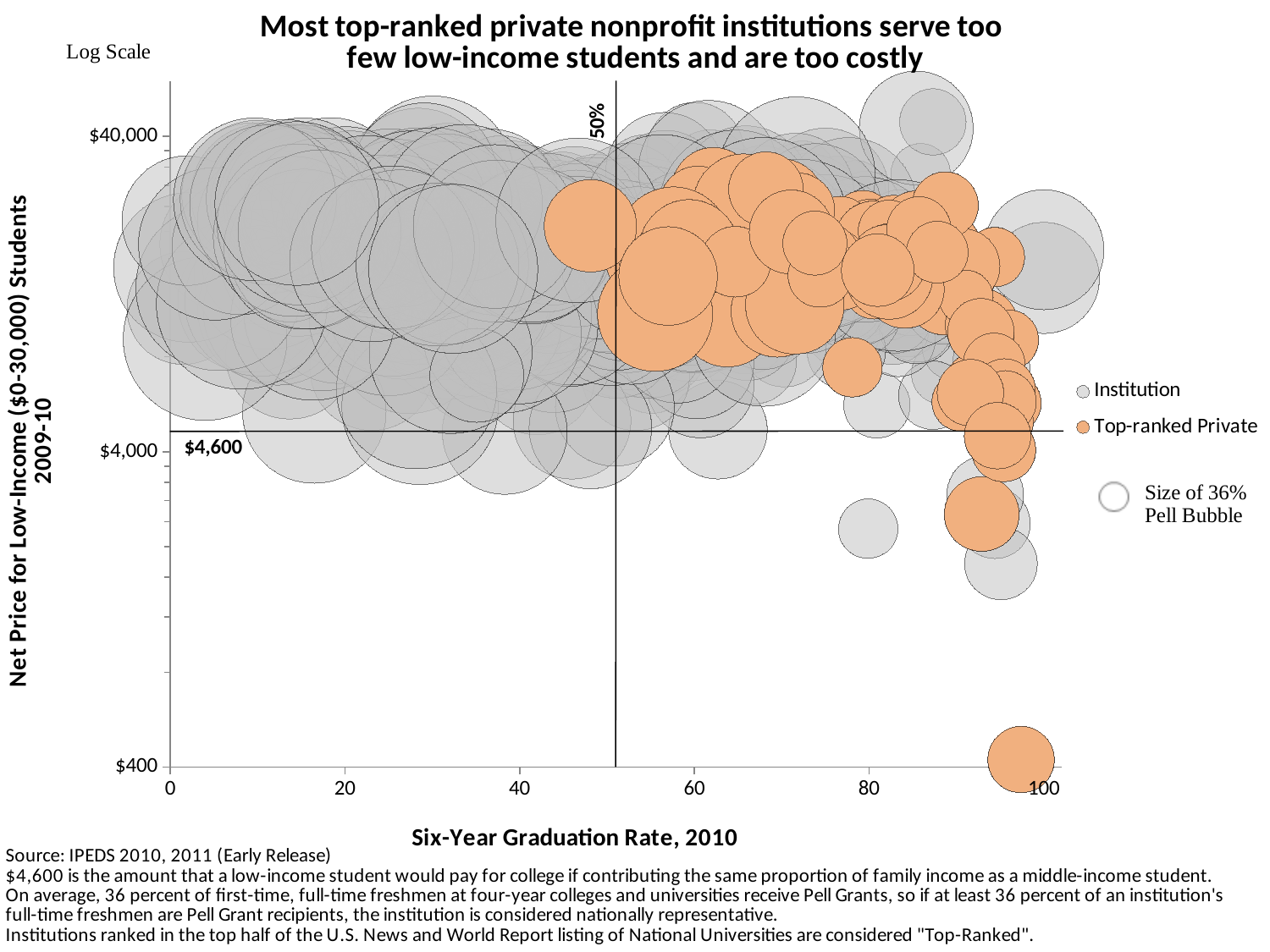
What net price value is marked by the horizontal reference line? $4,600 What is the title of the chart? Most top-ranked private nonprofit institutions serve too few low-income students and are too costly How many series does the legend list? 2 What is the label of the x axis? Six-Year Graduation Rate, 2010 What are the two series named in the legend? Institution and Top-ranked Private What kind of chart is shown on the slide? Bubble chart Is the net price of the lowest Top-ranked Private bubble greater or less than $4,000? less What graduation rate is marked by the vertical reference line? 50% Which series has bubbles mostly to the right of the 50% graduation rate line, Institution or Top-ranked Private? Top-ranked Private What is the lowest value labelled on the y axis? $400 Is the graduation rate of the lowest Top-ranked Private bubble greater or less than 80? greater What is the highest value labelled on the y axis? $40,000